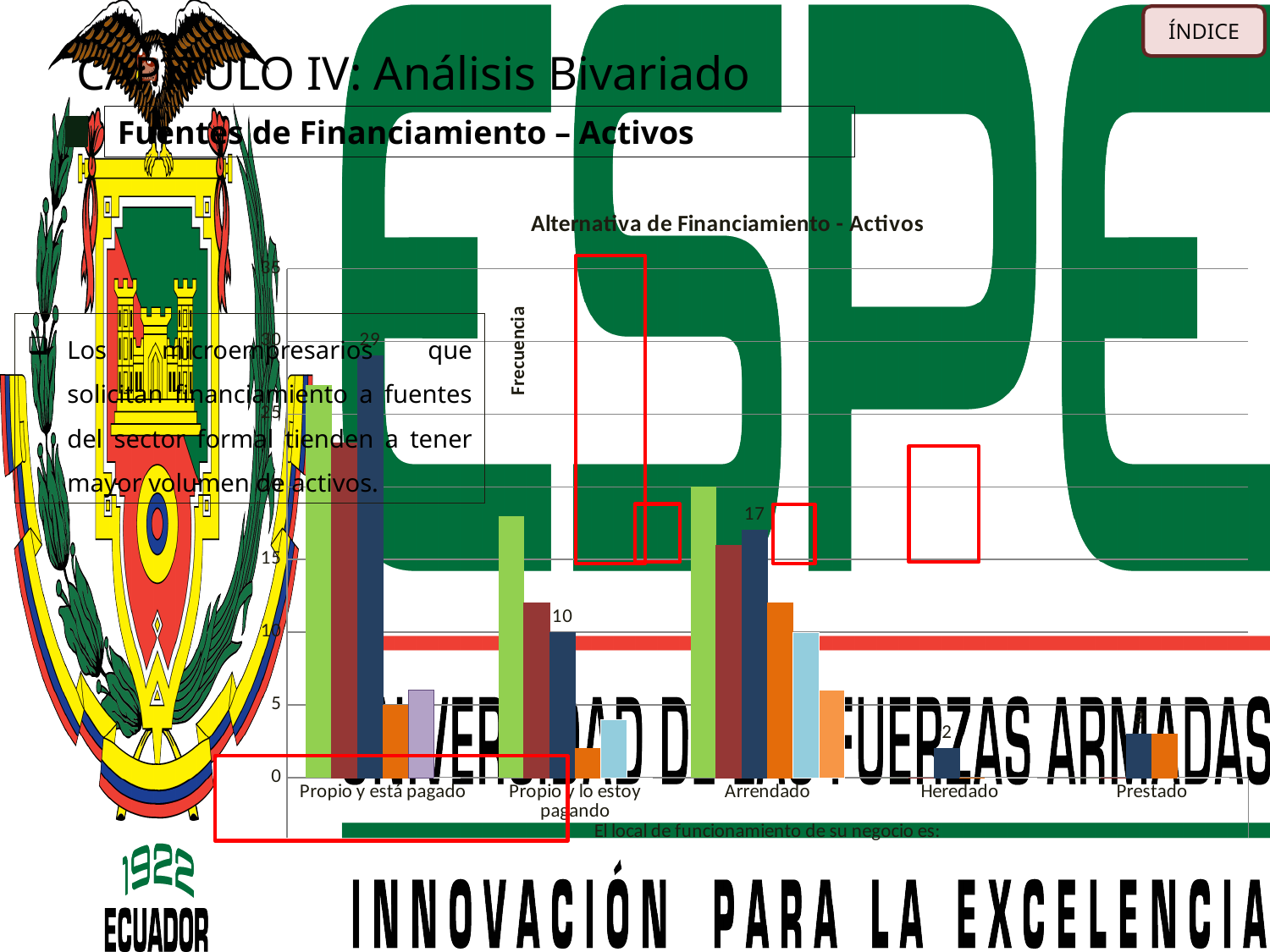
Among the labeled dark blue bars, which category has the highest value? Propio y está pagado Is the value of the green bar for 'Propio y está pagado' greater or less than 25? greater How many categories are shown on the x axis of the chart? 5 What is the value of the dark blue bar for 'Propio y lo estoy pagando'? 10 What is the difference between the dark blue bar values for 'Propio y está pagado' and 'Arrendado'? 12 What is the value of the dark blue bar for 'Arrendado'? 17 What is the value of the dark blue bar for 'Heredado'? 2 What kind of chart is shown on the slide? Bar chart What is the value of the dark blue bar for 'Propio y está pagado'? 29 Which dark blue bar is larger: 'Arrendado' or 'Propio y lo estoy pagando'? Arrendado What is the label on the vertical axis of the chart? Frecuencia What is the title of the chart? Alternativa de Financiamiento - Activos